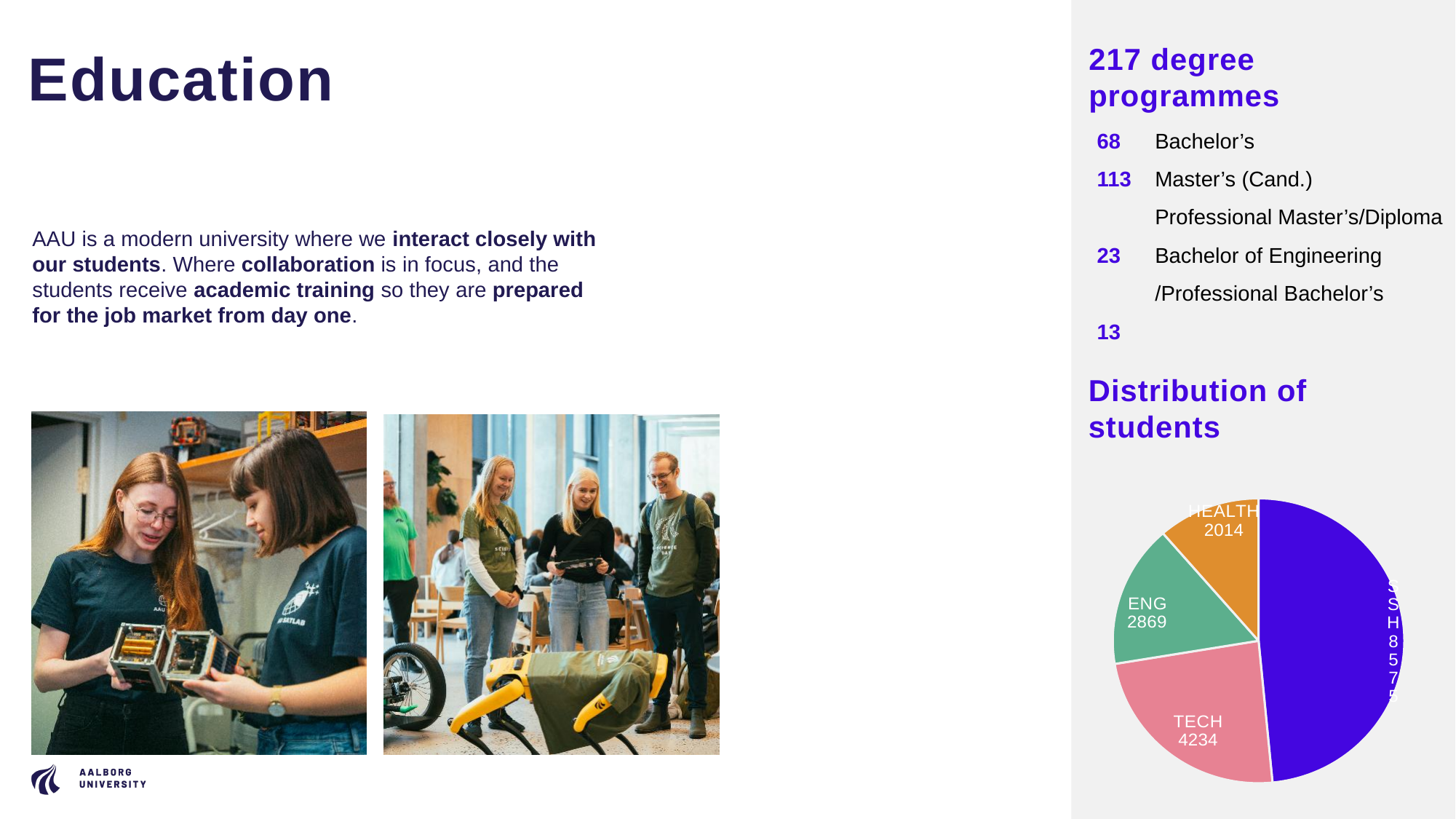
What is the value shown for ENG in the "Distribution of students" pie chart? 2869 Which category has the largest slice in the "Distribution of students" pie chart? SSH Which category has the smallest slice in the "Distribution of students" pie chart? HEALTH How many slices does the "Distribution of students" pie chart have? 4 What is the title of the pie chart on the slide? Distribution of students In the "Distribution of students" pie chart, what is the difference between the ENG and HEALTH values? 855 In the "Distribution of students" pie chart, which is larger, TECH or ENG? TECH What is the value shown for HEALTH in the "Distribution of students" pie chart? 2014 In the "Distribution of students" pie chart, what is the difference between the TECH and HEALTH values? 2220 In the "Distribution of students" pie chart, what is the difference between the TECH and ENG values? 1365 What kind of chart is shown under "Distribution of students"? Pie chart What is the value shown for TECH in the "Distribution of students" pie chart? 4234